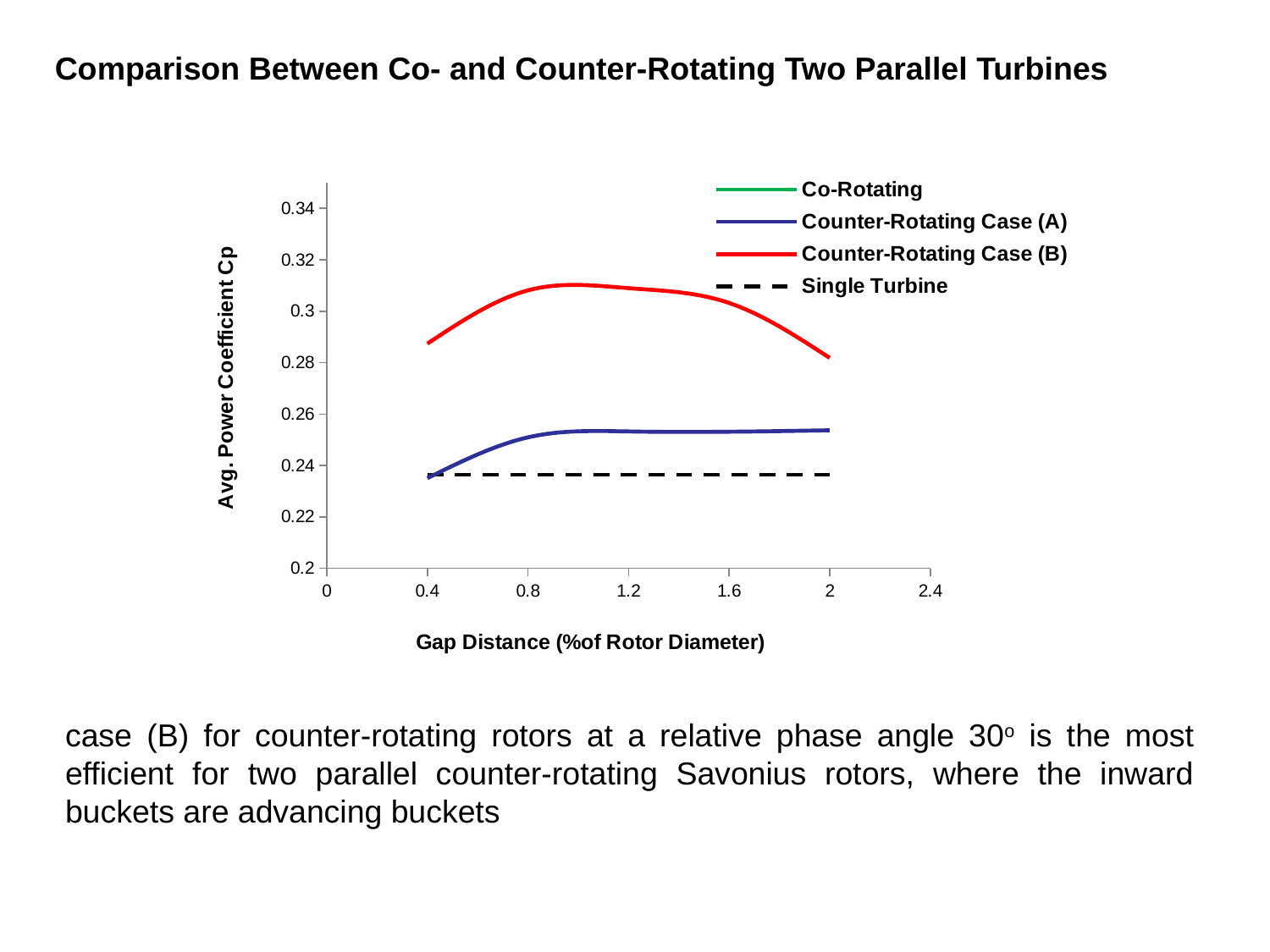
Is the value for Counter-Rotating Case (A) at a gap distance of 2 greater or less than 0.26? less Does the Counter-Rotating Case (B) line rise or fall between gap distances of 1.2 and 2? fall What kind of chart is shown on the slide? line chart At a gap distance of 1.2, which is larger: Counter-Rotating Case (B) or Counter-Rotating Case (A)? Counter-Rotating Case (B) How many series does the chart legend list? 4 At a gap distance of 2, which is larger: Counter-Rotating Case (A) or Single Turbine? Counter-Rotating Case (A) What is the title of the chart's x axis? Gap Distance (%of Rotor Diameter) Is the peak value of Counter-Rotating Case (B) greater or less than 0.3? greater What is the title of the chart's y axis? Avg. Power Coefficient Cp Is the value for Counter-Rotating Case (B) at a gap distance of 0.4 greater or less than 0.28? greater Which series has the highest Avg. Power Coefficient Cp values across the plotted gap distances? Counter-Rotating Case (B)